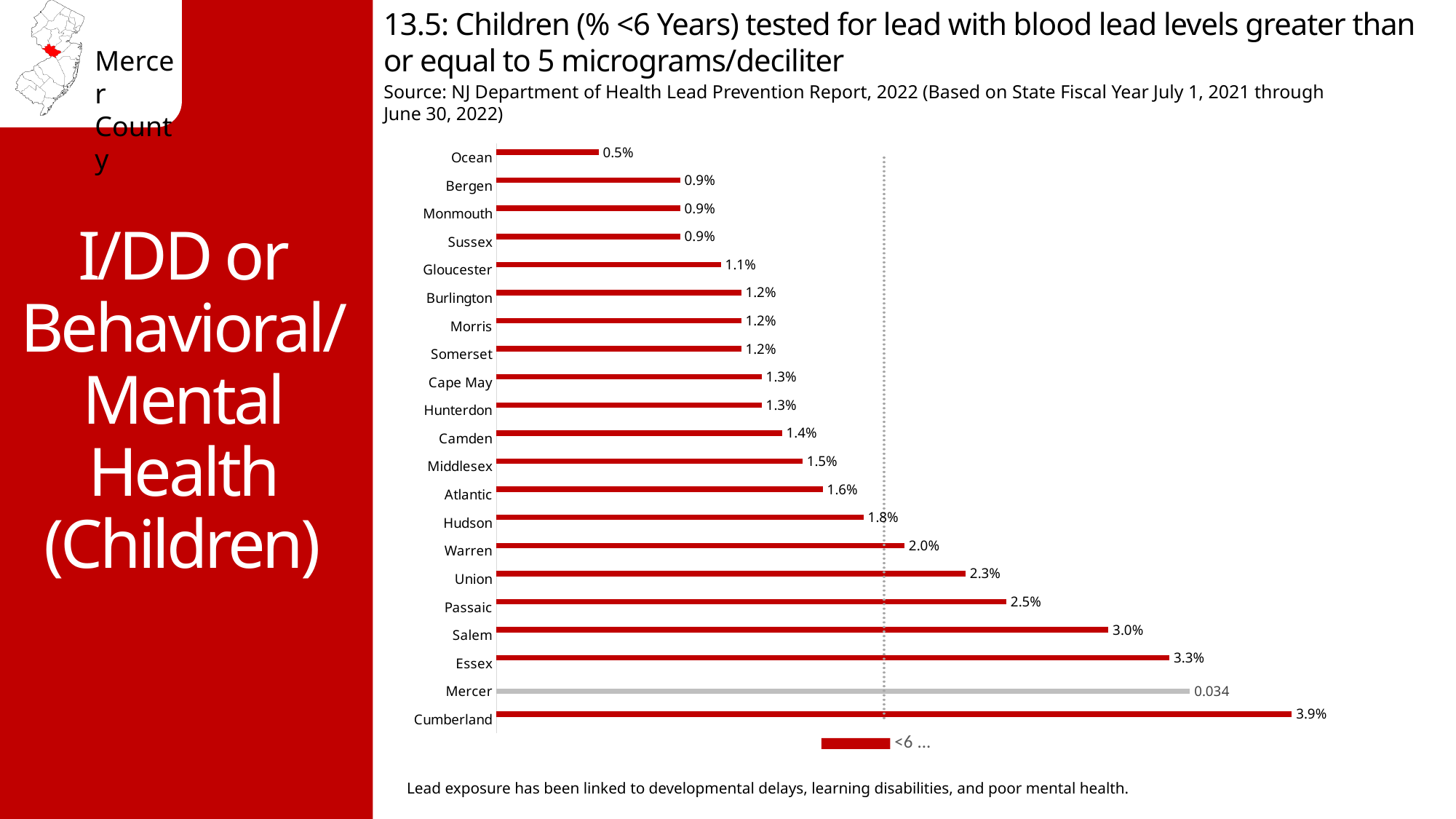
What type of chart is shown on the slide? bar chart What is the difference between the values for Cumberland and Essex? 0.6% What value is labeled for Mercer? 0.034 What is the value for Hudson? 1.8% What is the value for Ocean? 0.5% What is the difference between the values for Salem and Ocean? 2.5% How many counties are shown in the chart? 21 Which county has the lowest value? Ocean Which county has the highest value? Cumberland Which has a larger value, Union or Warren? Union What is the value for Passaic? 2.5% What is the value for Cumberland? 3.9%